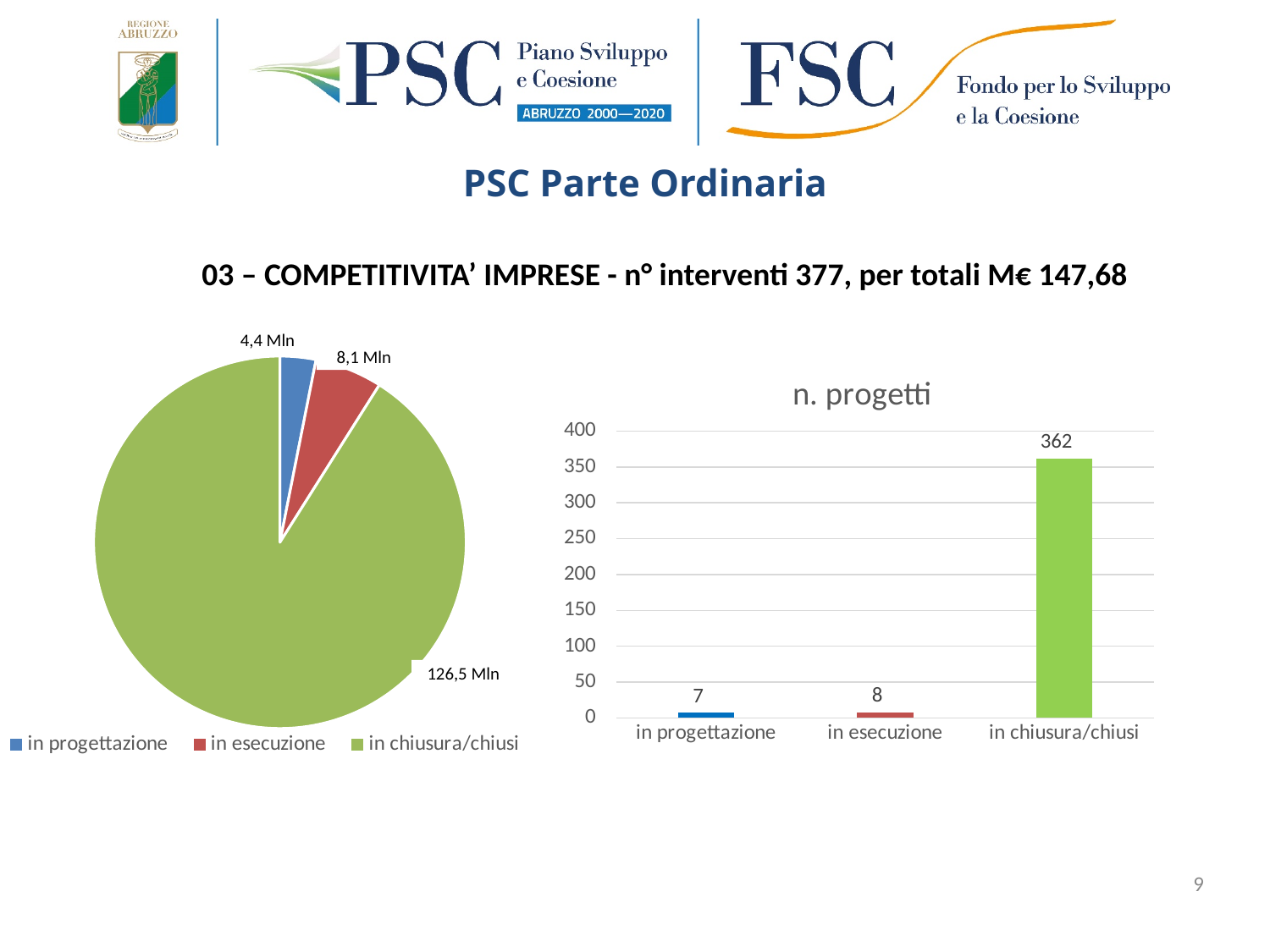
In the pie chart on the left of the slide, what is the value for 'in esecuzione'? 8,1 Mln In the bar chart titled 'n. progetti', what is the value for 'in progettazione'? 7 In the pie chart on the left of the slide, what is the value for 'in chiusura/chiusi'? 126,5 Mln In the pie chart on the left of the slide, how many entries does the legend list? 3 In the bar chart titled 'n. progetti', which category has the highest value? in chiusura/chiusi In the pie chart on the left of the slide, which slice is the smallest? in progettazione In the bar chart titled 'n. progetti', what is the value for 'in esecuzione'? 8 In the bar chart titled 'n. progetti', which category has the lowest value? in progettazione What kind of chart is the chart on the right of the slide, titled 'n. progetti'? bar chart In the bar chart titled 'n. progetti', how many categories are shown on the x axis? 3 In the bar chart titled 'n. progetti', what is the difference between the values for 'in chiusura/chiusi' and 'in esecuzione'? 354 In the bar chart titled 'n. progetti', what is the value for 'in chiusura/chiusi'? 362